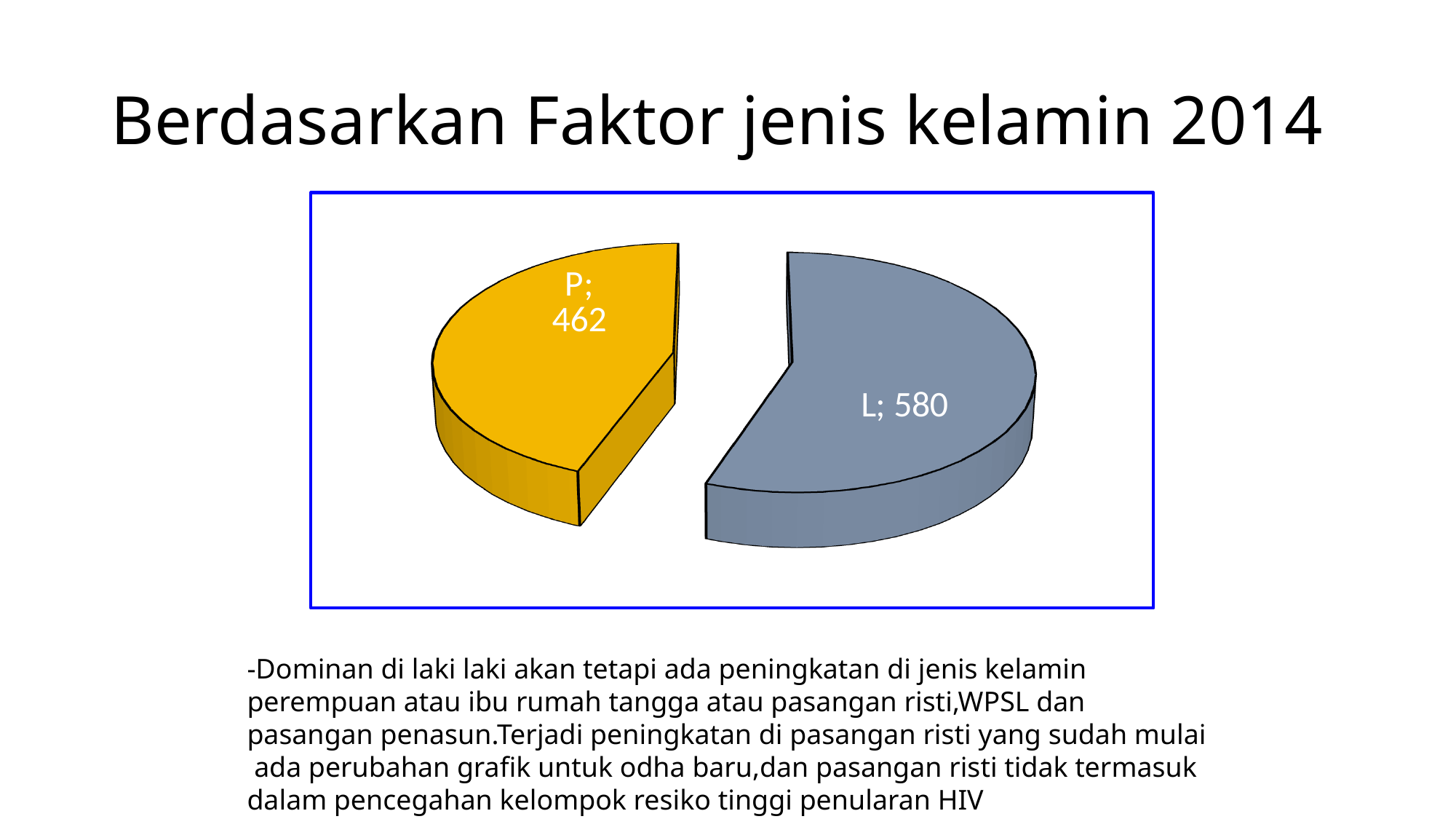
What kind of chart is shown on the slide? Pie chart What colour is the P slice in the pie chart? Yellow Which is larger in the pie chart, the value for L or the value for P? L What is the value for L in the pie chart? 580 What is the title of the slide containing the pie chart? Berdasarkan Faktor jenis kelamin 2014 Which slice of the pie chart is the largest? L What is the difference between the values for L and P in the pie chart? 118 What is the value for P in the pie chart? 462 What share of the pie chart does the L slice represent, to one decimal place? 55.7% What is the total of the two slices in the pie chart? 1042 Which slice of the pie chart is the smallest? P How many slices does the pie chart have? 2